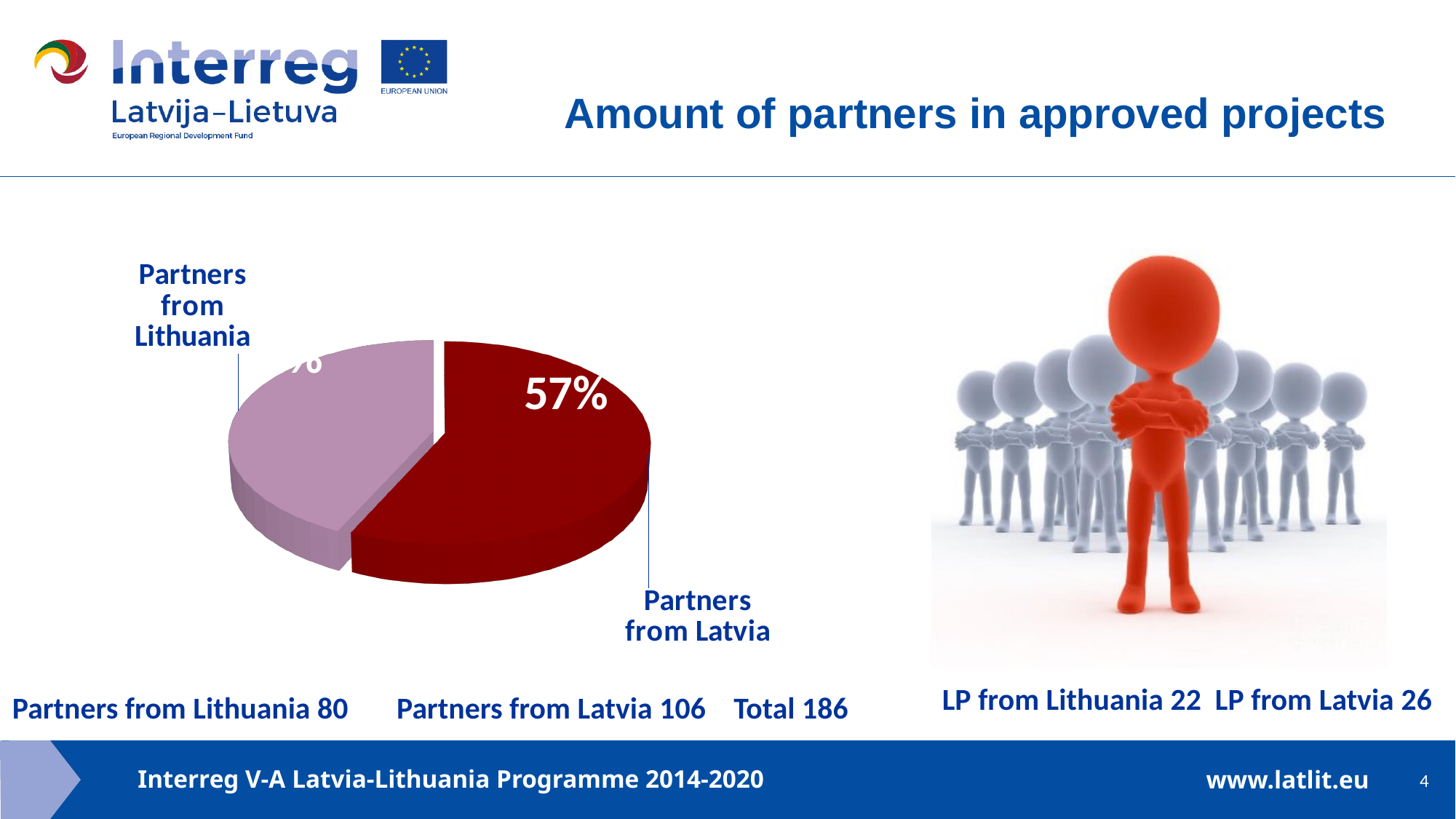
Which is larger in the pie chart, Partners from Latvia or Partners from Lithuania? Partners from Latvia What is the total number of partners stated below the pie chart? 186 How many slices does the pie chart have? 2 What percentage of the pie is labelled for Partners from Latvia? 57% According to the text below the pie chart, how many partners are from Lithuania? 80 Which slice of the pie chart is the largest? Partners from Latvia Is the share for Partners from Latvia greater or less than 50%? greater How many more partners are from Latvia than from Lithuania, based on the numbers below the pie chart? 26 According to the text below the pie chart, how many partners are from Latvia? 106 What is the title of the slide containing the pie chart? Amount of partners in approved projects What kind of chart is shown on the slide? pie chart Which slice of the pie chart is the smallest? Partners from Lithuania